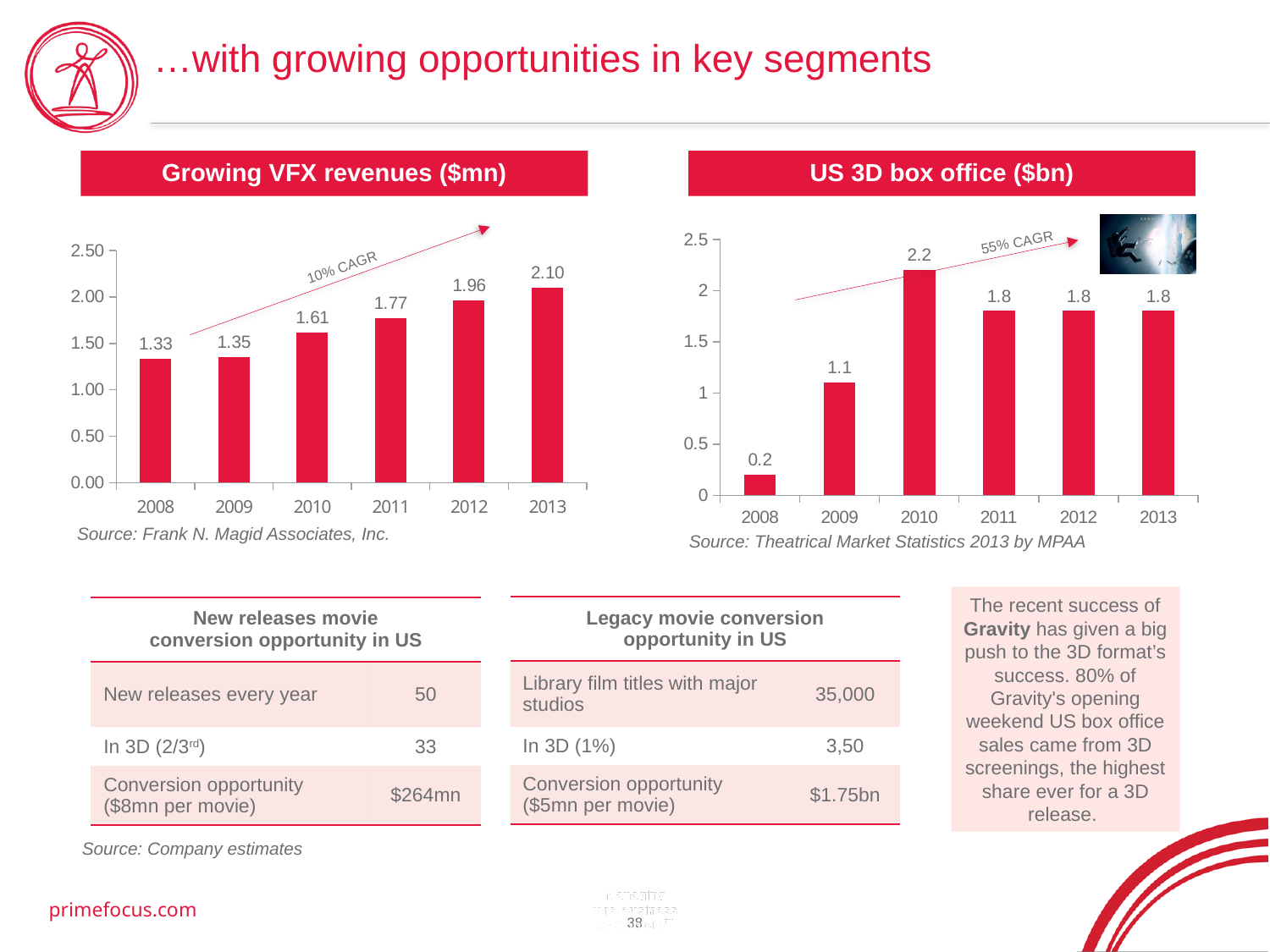
In the 'Growing VFX revenues ($mn)' chart, how many years are plotted? 6 In the 'US 3D box office ($bn)' chart, which year has the highest value? 2010 In the 'US 3D box office ($bn)' chart, which year has the lowest value? 2008 In the 'US 3D box office ($bn)' chart, which is larger, the value for 2009 or the value for 2012? 2012 In the 'Growing VFX revenues ($mn)' chart, what is the value for 2010? 1.61 In the 'Growing VFX revenues ($mn)' chart, which year has the lowest value? 2008 In the 'Growing VFX revenues ($mn)' chart, what is the difference between the 2013 and 2008 values? 0.77 In the 'Growing VFX revenues ($mn)' chart, which year has the highest value? 2013 In the 'Growing VFX revenues ($mn)' chart, do the values rise or fall from 2008 to 2013? rise In the 'US 3D box office ($bn)' chart, what is the difference between the 2010 and 2011 values? 0.4 In the 'US 3D box office ($bn)' chart, what is the value for 2009? 1.1 What kind of chart is the 'US 3D box office ($bn)' chart? bar chart